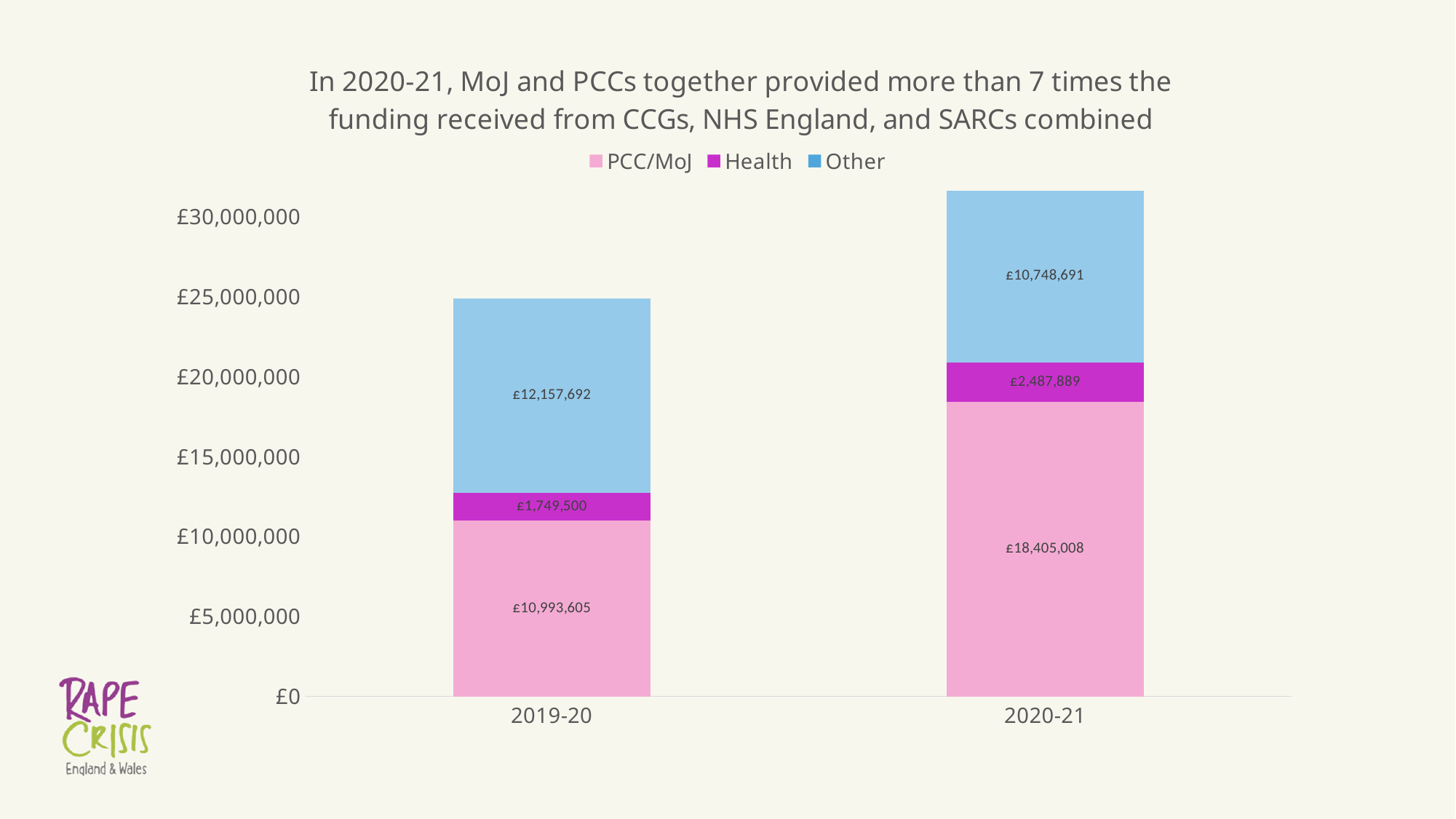
What is the total funding shown for the 2019-20 stacked bar? £24,900,797 What was the PCC/MoJ funding in 2020-21? £18,405,008 How many series does the legend list? 3 What was the Health funding in 2020-21? £2,487,889 Which year had the higher Other funding? 2019-20 Which colour represents the Health series in the chart? Purple Which year had the higher PCC/MoJ funding? 2020-21 What was the Other funding in 2019-20? £12,157,692 What was the Health funding in 2019-20? £1,749,500 By how much did PCC/MoJ funding increase from 2019-20 to 2020-21? £7,411,403 What is the total funding shown for the 2020-21 stacked bar? £31,641,588 What kind of chart is shown on the slide? Stacked bar chart